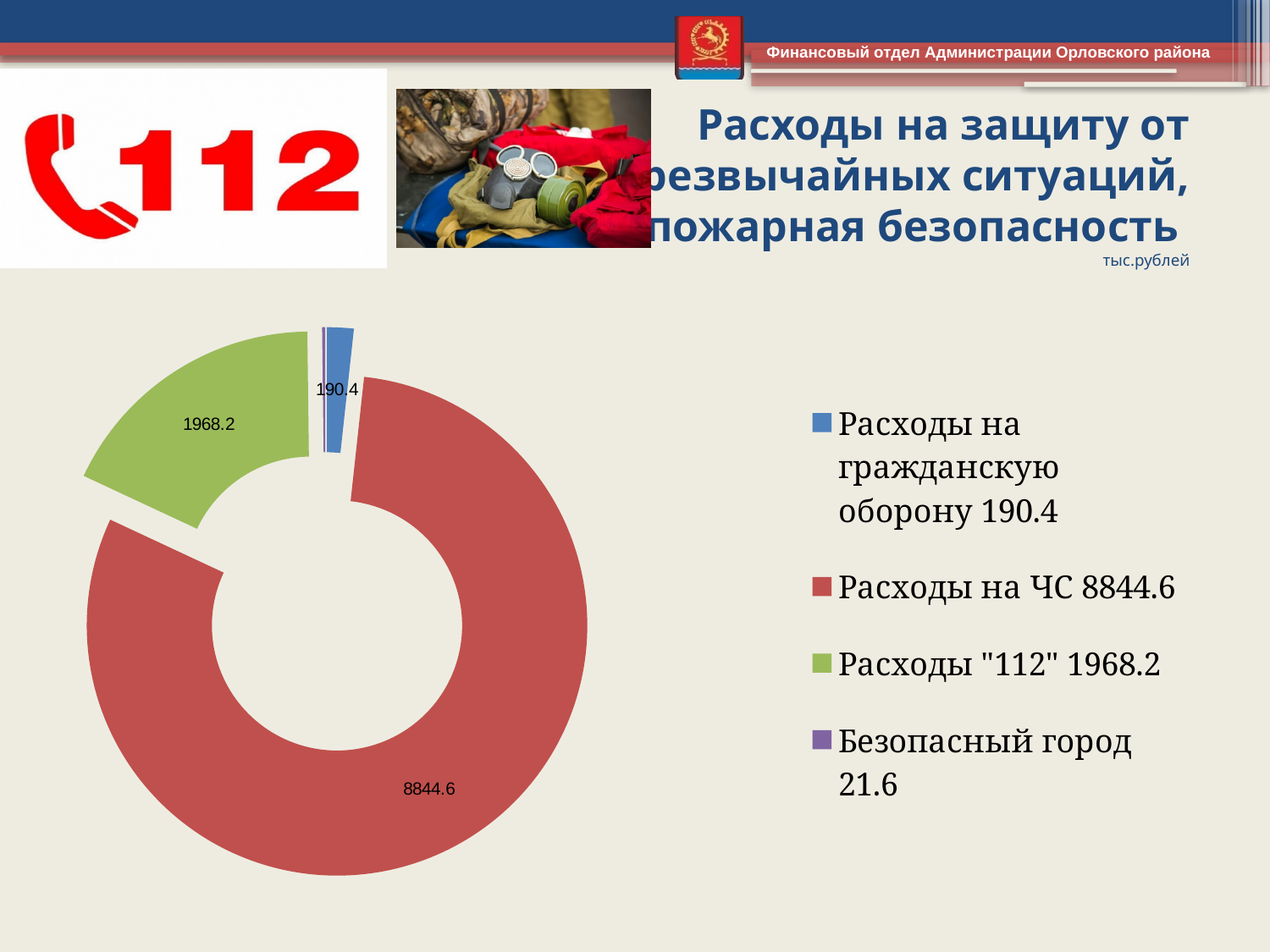
What is the value for Расходы на гражданскую оборону? 190.4 What is the value for Расходы на ЧС? 8844.6 Which category has the largest value? Расходы на ЧС What type of chart is shown on the slide? doughnut chart Which is larger, Расходы на гражданскую оборону or Безопасный город? Расходы на гражданскую оборону What is the value for Безопасный город? 21.6 Which category has the smallest value? Безопасный город What unit is stated for the chart values? тыс.рублей What is the difference between Расходы на ЧС and Расходы "112"? 6876.4 How many categories does the chart show? 4 What is the difference between Расходы "112" and Расходы на гражданскую оборону? 1777.8 What is the value for Расходы "112"? 1968.2